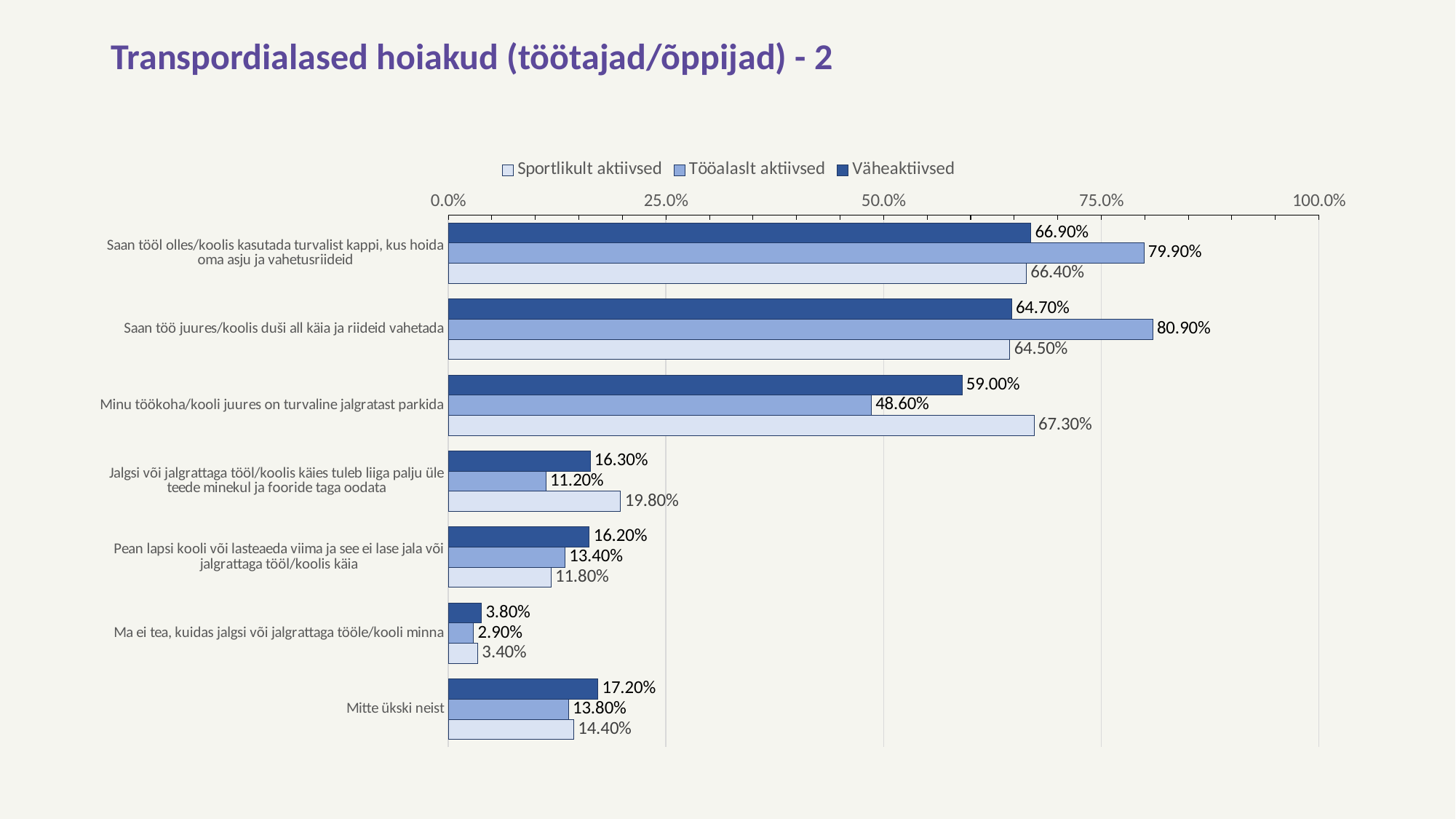
How many categories are shown on the chart? 7 What is the difference between the Tööalaslt aktiivsed and Sportlikult aktiivsed values for "Saan tööl olles/koolis kasutada turvalist kappi, kus hoida oma asju ja vahetusriideid"? 13.50% What kind of chart is shown on the slide? bar chart Which category has the highest value for Sportlikult aktiivsed? Minu töökoha/kooli juures on turvaline jalgratast parkida How many series does the legend list? 3 For "Minu töökoha/kooli juures on turvaline jalgratast parkida", which is larger: the Väheaktiivsed value or the Tööalaslt aktiivsed value? Väheaktiivsed What is the title of the chart on the slide? Transpordialased hoiakud (töötajad/õppijad) - 2 What is the value for Tööalaslt aktiivsed for "Saan töö juures/koolis duši all käia ja riideid vahetada"? 80.90% What is the value for Sportlikult aktiivsed for "Minu töökoha/kooli juures on turvaline jalgratast parkida"? 67.30% What is the value for Väheaktiivsed for "Mitte ükski neist"? 17.20% Is the Väheaktiivsed value for "Saan töö juures/koolis duši all käia ja riideid vahetada" greater or less than 50.0%? greater Which category has the lowest value for Tööalaslt aktiivsed? Ma ei tea, kuidas jalgsi või jalgrattaga tööle/kooli minna